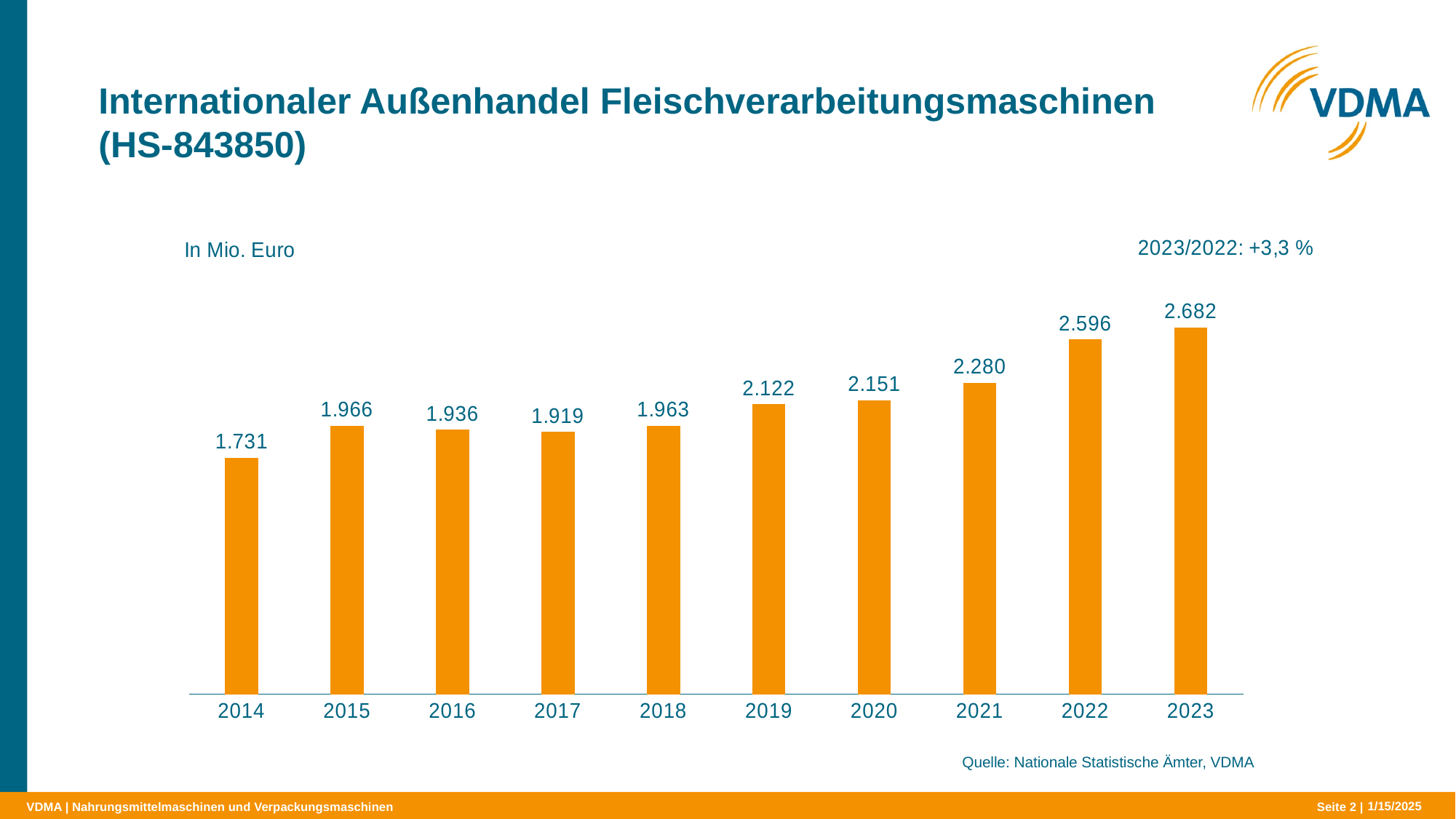
Which is larger, the value for 2015 or the value for 2017? 2015 Which year has the highest value? 2023 Which year has the lowest value? 2014 What is the value for 2014? 1.731 What is the value for 2023? 2.682 How many years are shown on the x axis? 10 What kind of chart is shown on the slide? bar chart What is the difference between the values for 2023 and 2022? 86 What is the difference between the values for 2023 and 2014? 951 What is the value for 2019? 2.122 In what unit are the values given, according to the label above the chart? In Mio. Euro Do the values generally rise or fall from 2018 to 2023? rise